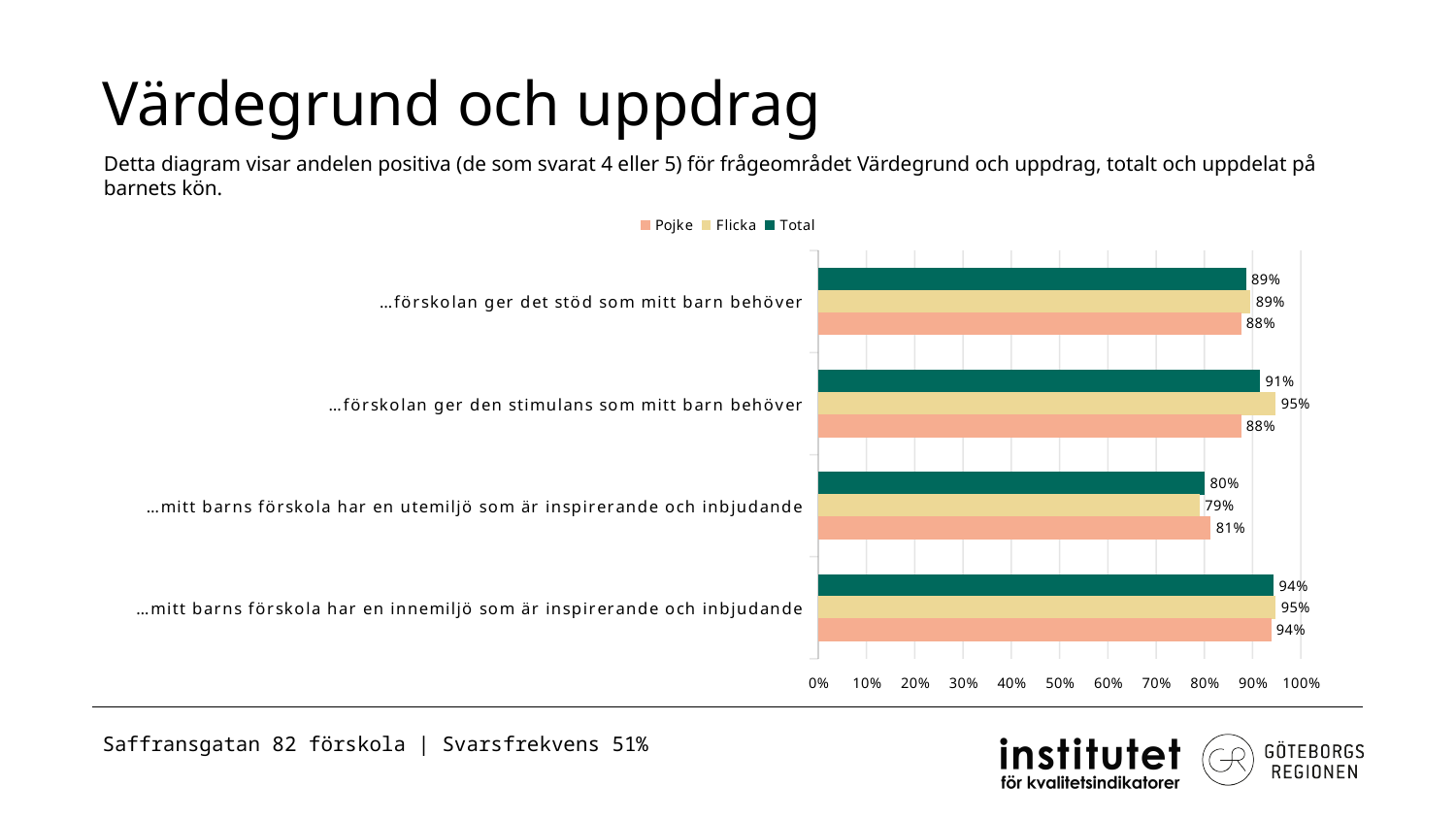
What kind of chart is shown on the slide? Bar chart Which category has the lowest Flicka value? …mitt barns förskola har en utemiljö som är inspirerande och inbjudande How many categories (question statements) are shown in the chart? 4 What is the Flicka value for "…förskolan ger det stöd som mitt barn behöver"? 89% Which series is shown in green in the chart? Total How many series does the legend list? 3 What is the difference between the Flicka and Pojke values for "…förskolan ger den stimulans som mitt barn behöver"? 7 percentage points For "…mitt barns förskola har en utemiljö som är inspirerande och inbjudande", which is larger: the Pojke value or the Flicka value? Pojke Is the Total value for "…mitt barns förskola har en utemiljö som är inspirerande och inbjudande" greater or less than 90%? less What is the Pojke value for "…mitt barns förskola har en utemiljö som är inspirerande och inbjudande"? 81% What is the Total value for "…förskolan ger den stimulans som mitt barn behöver"? 91% Which category has the highest Total value? …mitt barns förskola har en innemiljö som är inspirerande och inbjudande